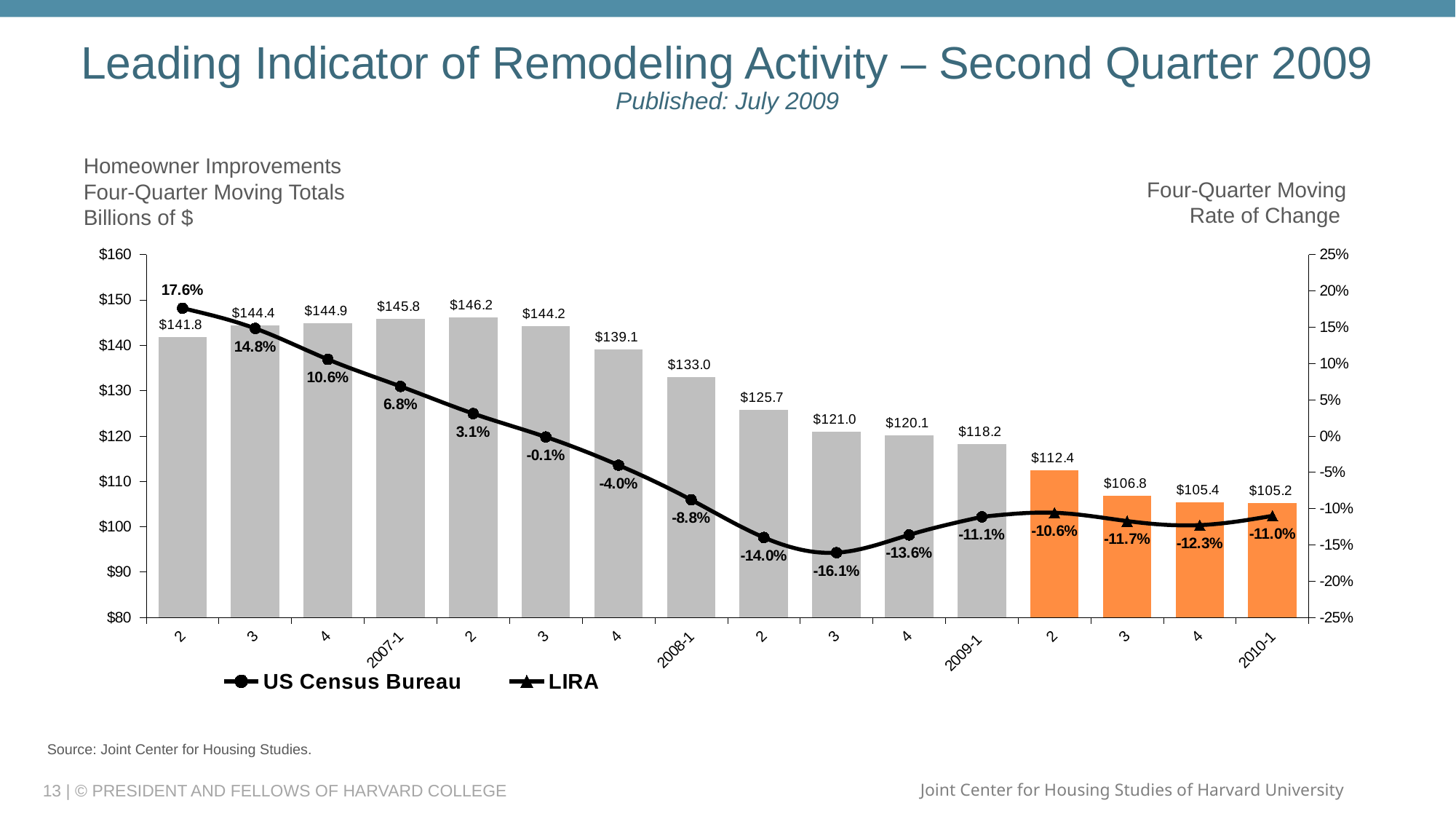
What is the difference between the four-quarter moving totals for 2008-1 and 2009-1? $14.8 What is the four-quarter moving rate of change shown for 2009-1? -11.1% What is the four-quarter moving total for 2010-1? $105.2 How many bars are plotted in the chart? 16 Which bar has the highest four-quarter moving total? $146.2 (quarter 2 of 2007) What is the lowest four-quarter moving rate of change plotted on the line? -16.1% What is the four-quarter moving total for 2007-1? $145.8 Which is larger, the four-quarter moving total for 2007-1 or for 2008-1? 2007-1 What is the four-quarter moving rate of change shown for 2008-1? -8.8% Do the four-quarter moving totals generally rise or fall from 2007-1 to 2010-1? Fall How many series does the legend list? 2 What kind of chart is shown on the slide? Combined bar and line chart